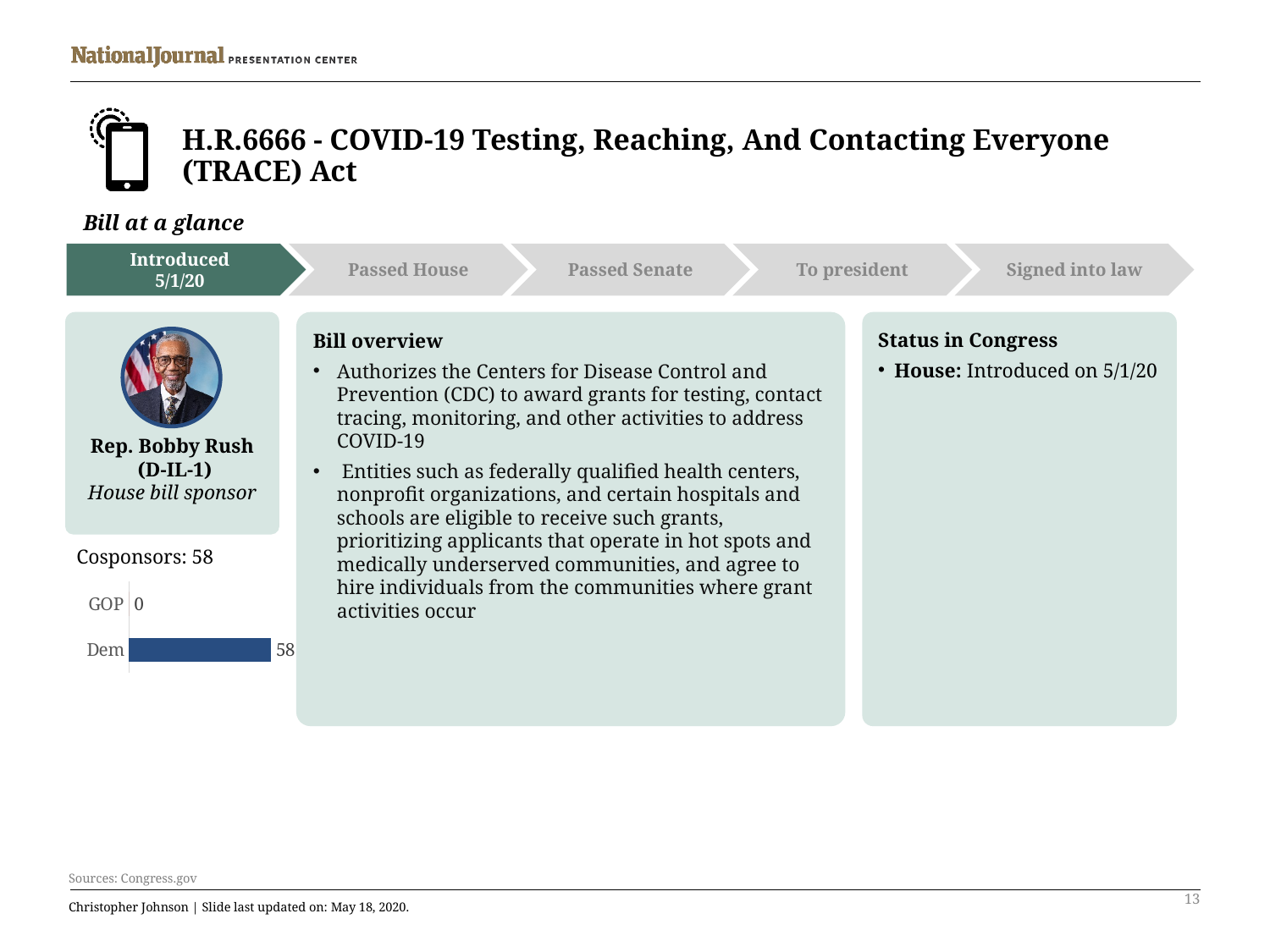
Which category has the highest value in the cosponsors chart? Dem What is the value for GOP in the cosponsors chart? 0 What kind of chart is the cosponsors chart? Bar chart What is the difference between the Dem and GOP values in the cosponsors chart? 58 What colour is the Dem bar in the cosponsors chart? Blue What is the total number of cosponsors shown above the chart? 58 Which category has the lowest value in the cosponsors chart? GOP What is the value for Dem in the cosponsors chart? 58 How many categories are shown in the cosponsors chart? 2 Which is larger in the cosponsors chart, GOP or Dem? Dem